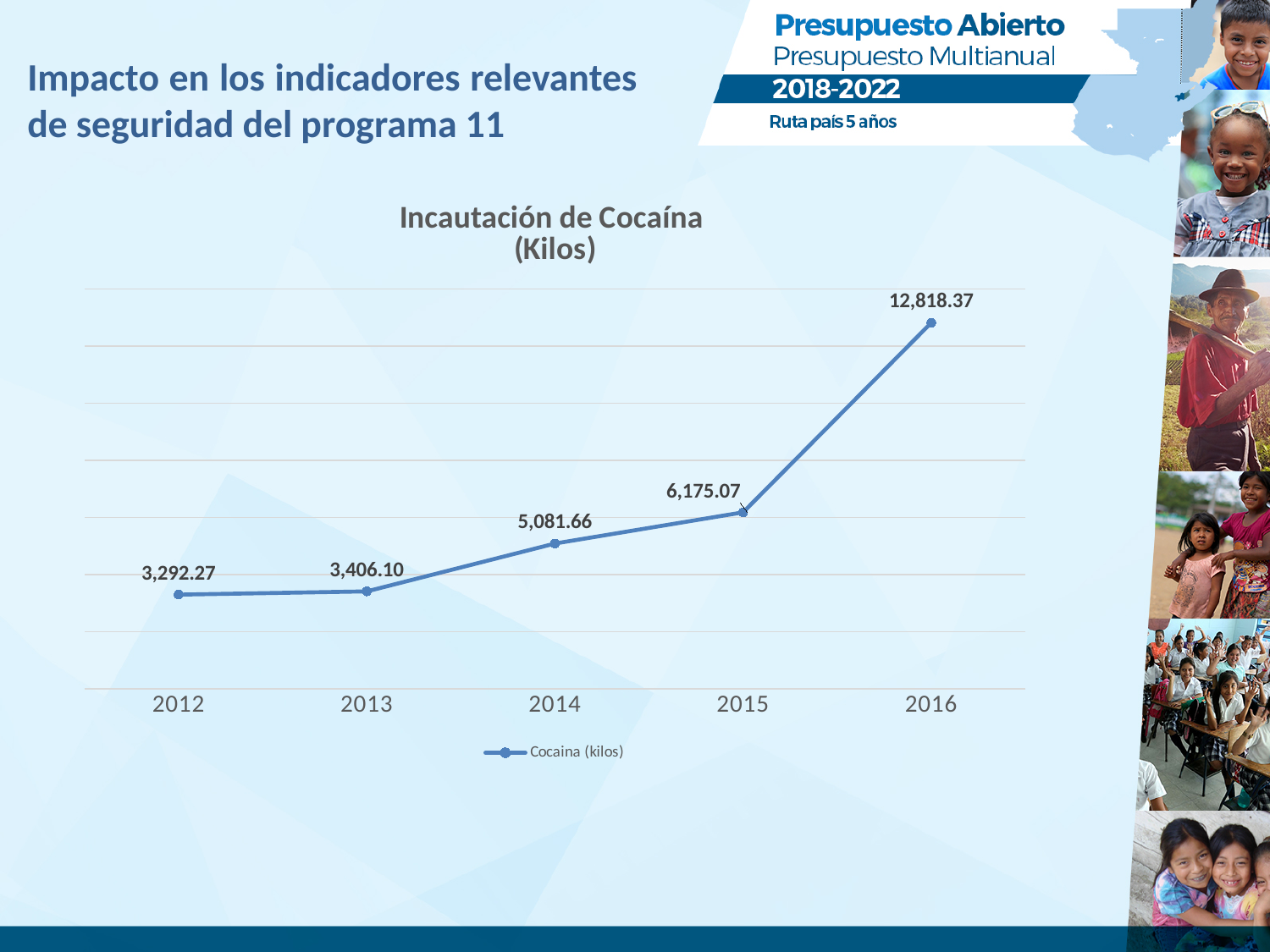
What is the difference between the 2016 and 2015 values in the 'Incautación de Cocaína (Kilos)' chart? 6,643.30 Which year has the lowest value in the 'Incautación de Cocaína (Kilos)' chart? 2012 What is the value for 2016 in the 'Incautación de Cocaína (Kilos)' chart? 12,818.37 Do the values in the 'Incautación de Cocaína (Kilos)' chart rise or fall from 2012 to 2016? Rise Which year has the larger value in the 'Incautación de Cocaína (Kilos)' chart, 2014 or 2015? 2015 How many years are plotted in the 'Incautación de Cocaína (Kilos)' chart? 5 Which year has the highest value in the 'Incautación de Cocaína (Kilos)' chart? 2016 What is the difference between the 2013 and 2012 values in the 'Incautación de Cocaína (Kilos)' chart? 113.83 What kind of chart is 'Incautación de Cocaína (Kilos)'? Line chart What is the value for 2012 in the 'Incautación de Cocaína (Kilos)' chart? 3,292.27 How many series does the legend of the 'Incautación de Cocaína (Kilos)' chart list? 1 What is the value for 2014 in the 'Incautación de Cocaína (Kilos)' chart? 5,081.66